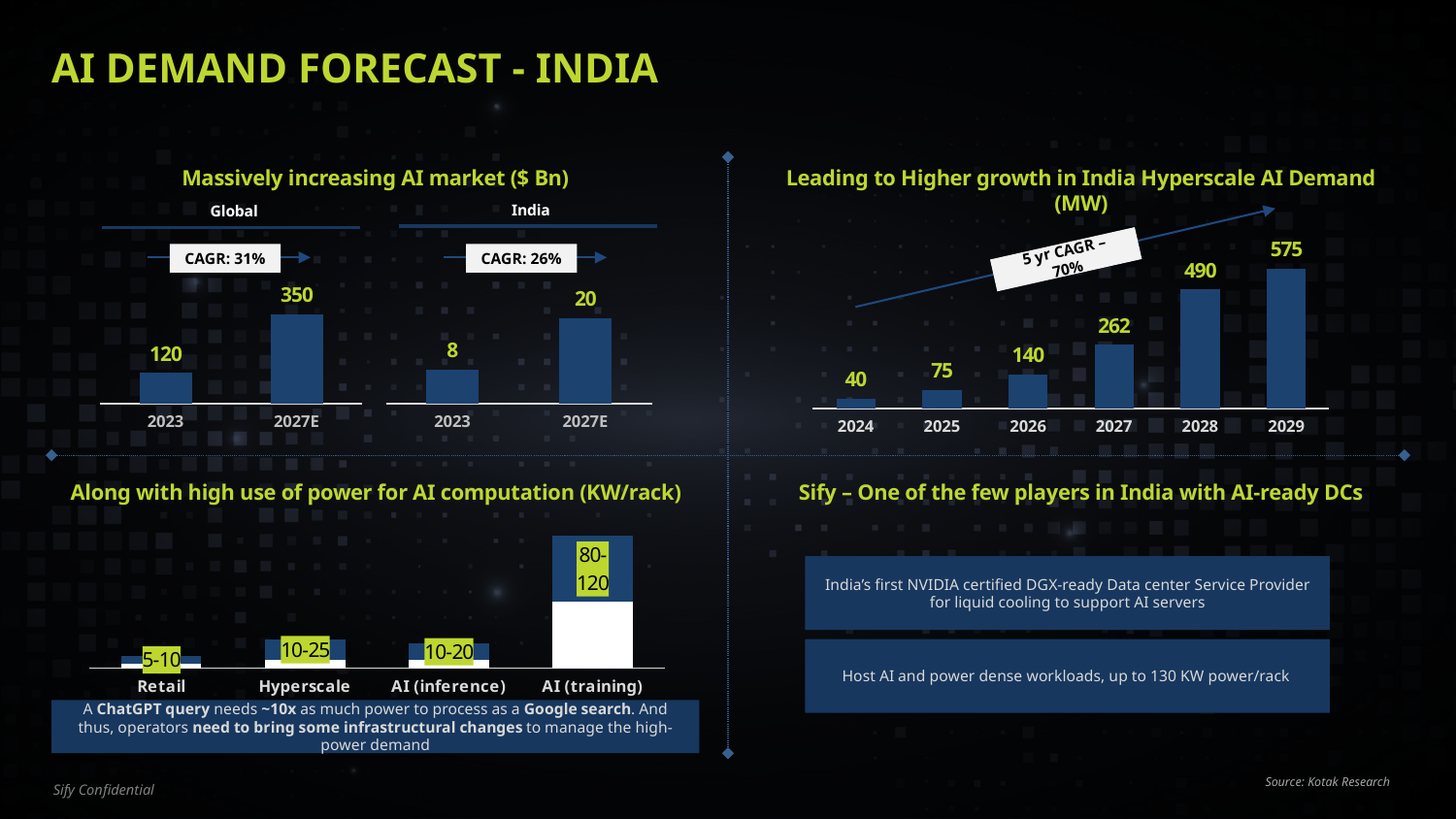
In the 'Leading to Higher growth in India Hyperscale AI Demand (MW)' chart, what is the value for 2027? 262 In the 'Along with high use of power for AI computation (KW/rack)' chart, what is the value shown for AI (training)? 80-120 In the 'Leading to Higher growth in India Hyperscale AI Demand (MW)' chart, which year has the lowest value? 2024 In the 'Leading to Higher growth in India Hyperscale AI Demand (MW)' chart, which year has the highest value? 2029 In the 'Leading to Higher growth in India Hyperscale AI Demand (MW)' chart, what is the difference between the 2029 and 2028 values? 85 In the 'Massively increasing AI market ($ Bn)' chart, what is the Global value for 2023? 120 In the 'Leading to Higher growth in India Hyperscale AI Demand (MW)' chart, how many years are plotted? 6 In the 'Massively increasing AI market ($ Bn)' chart, what is the India value for 2027E? 20 In the 'Massively increasing AI market ($ Bn)' chart, what is the difference between the Global values for 2027E and 2023? 230 In the 'Leading to Higher growth in India Hyperscale AI Demand (MW)' chart, do the values rise or fall from 2024 to 2029? rise What kind of chart is 'Along with high use of power for AI computation (KW/rack)'? bar chart In the 'Massively increasing AI market ($ Bn)' chart, what CAGR is shown for India? 26%